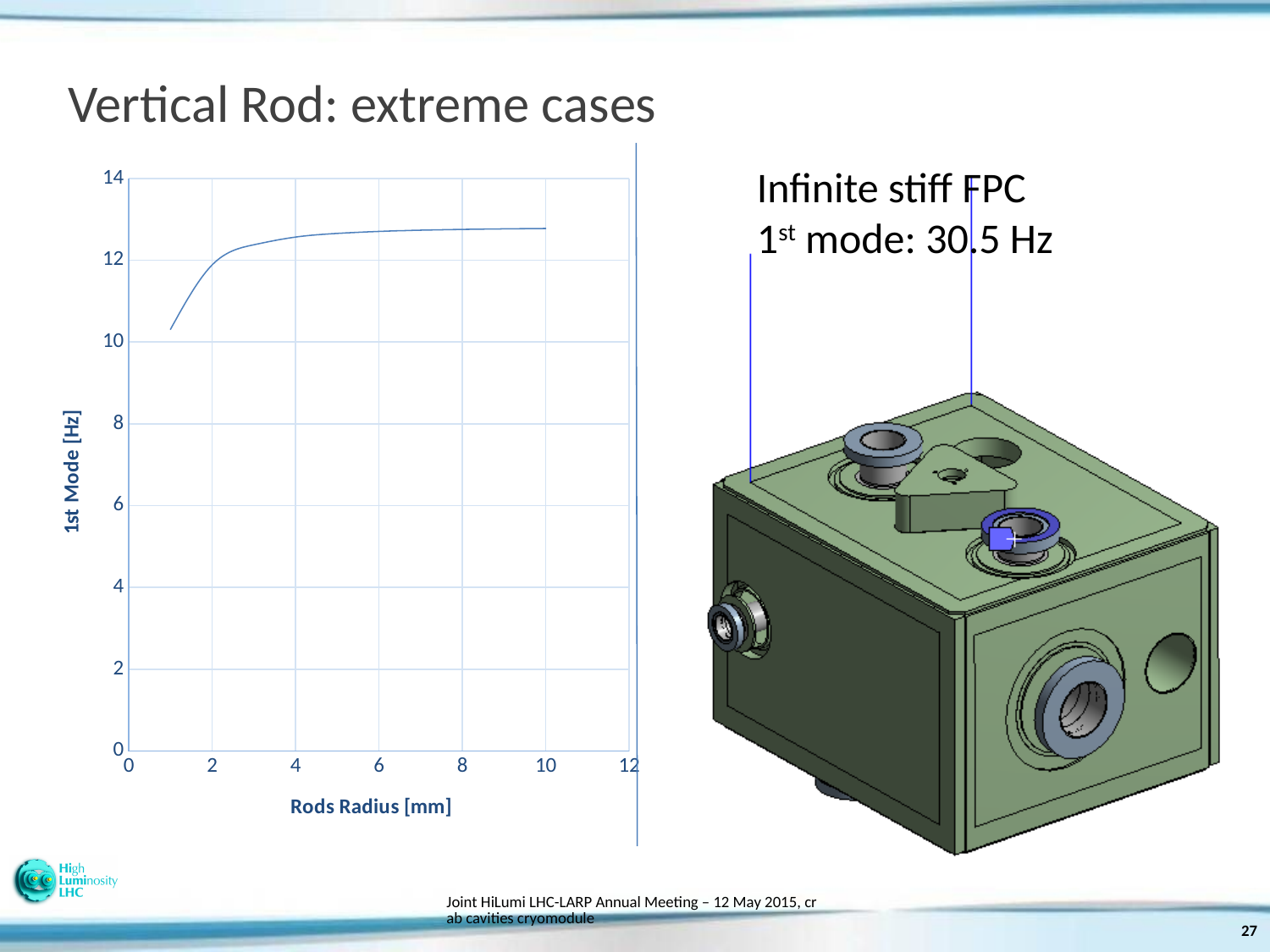
Is the 1st mode value at a rod radius of 10 mm greater or less than 12 Hz? greater What kind of chart is shown on the slide? line chart Is the 1st mode value at a rod radius of 8 mm greater or less than 10 Hz? greater Is the 1st mode value at a rod radius of 6 mm greater or less than 14 Hz? less Does the 1st mode frequency rise or fall as the rod radius increases? rise Which is larger: the 1st mode value at a rod radius of 1 mm or at a rod radius of 10 mm? 10 mm What is the label of the y axis of the chart? 1st Mode [Hz] What is the label of the x axis of the chart? Rods Radius [mm]